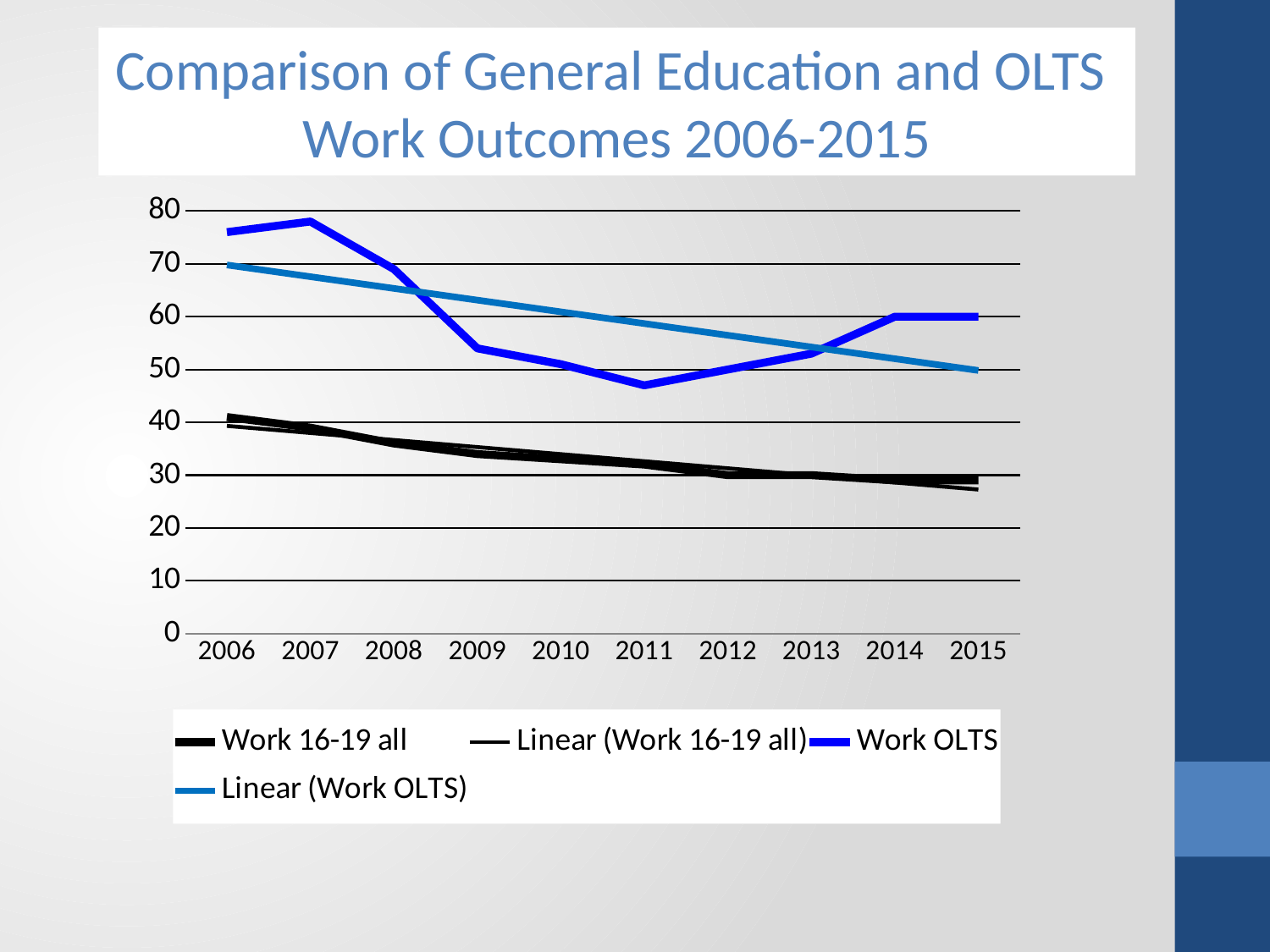
How many years are shown on the x axis? 10 Is the value for Work OLTS in 2011 greater or less than 50? less In which year is the Work OLTS line at its highest? 2007 In 2006, which series has the larger value, Work OLTS or Work 16-19 all? Work OLTS How many entries does the legend list? 4 Is the value for Work 16-19 all in 2008 greater or less than 40? less Is the value for Work OLTS in 2006 greater or less than 70? greater Does the Work 16-19 all line generally rise or fall from 2006 to 2015? fall In which year is the Work 16-19 all line at its highest? 2006 In which year is the Work OLTS line at its lowest? 2011 What is the title of the chart? Comparison of General Education and OLTS Work Outcomes 2006-2015 What kind of chart is shown on the slide? line chart